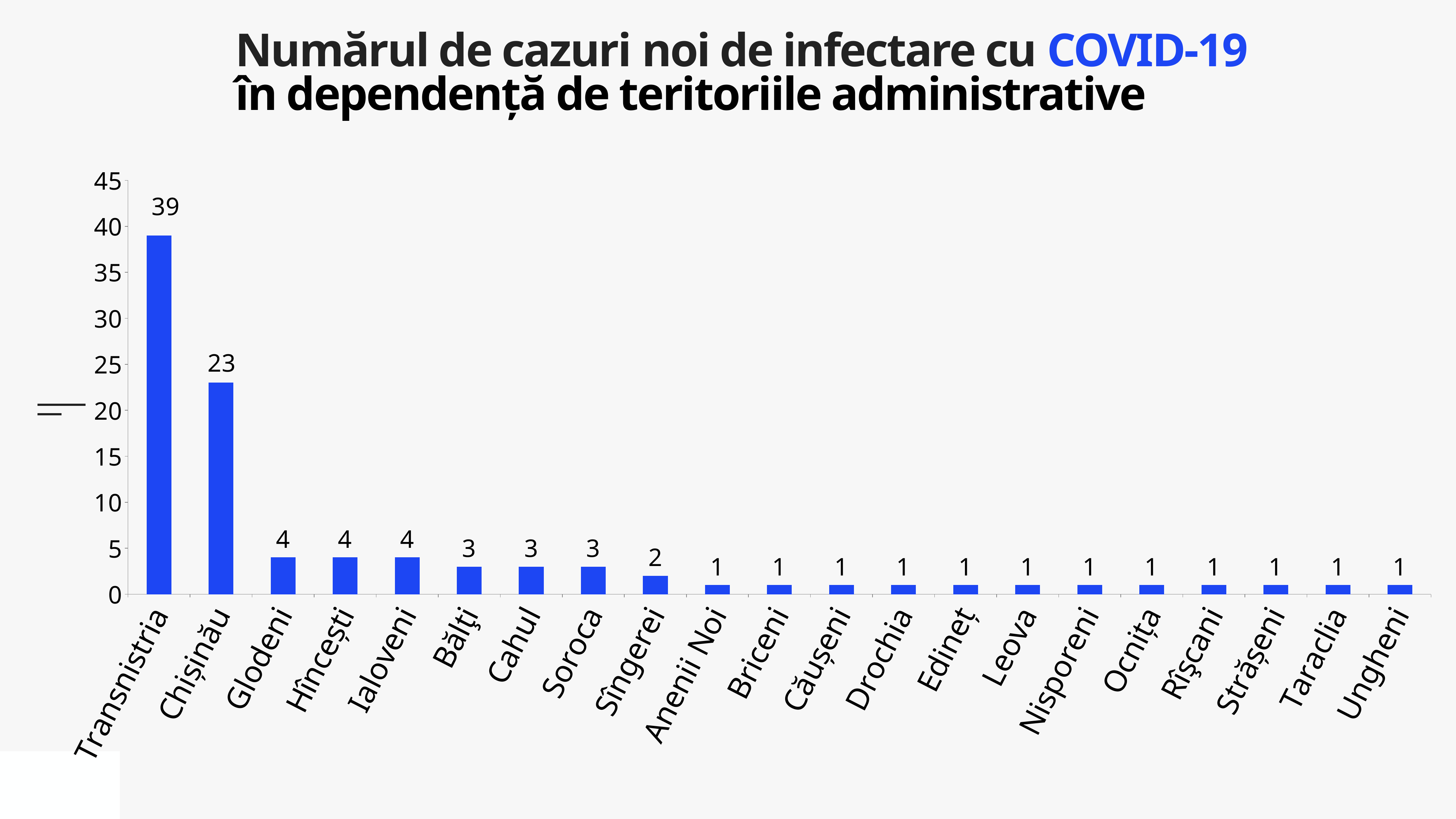
How many categories are shown on the x axis? 21 What is the difference between the values for Transnistria and Chișinău? 16 What is the value for Sîngerei? 2 What is the value for Chișinău? 23 What is the value for Transnistria? 39 Do the values rise or fall from left to right along the x axis? fall Is the value for Transnistria greater or less than 35? greater What is the value for Bălţi? 3 Which is larger, the value for Chișinău or the value for Glodeni? Chișinău Which category has the highest value? Transnistria What kind of chart is shown on the slide? bar chart What is the difference between the values for Glodeni and Soroca? 1